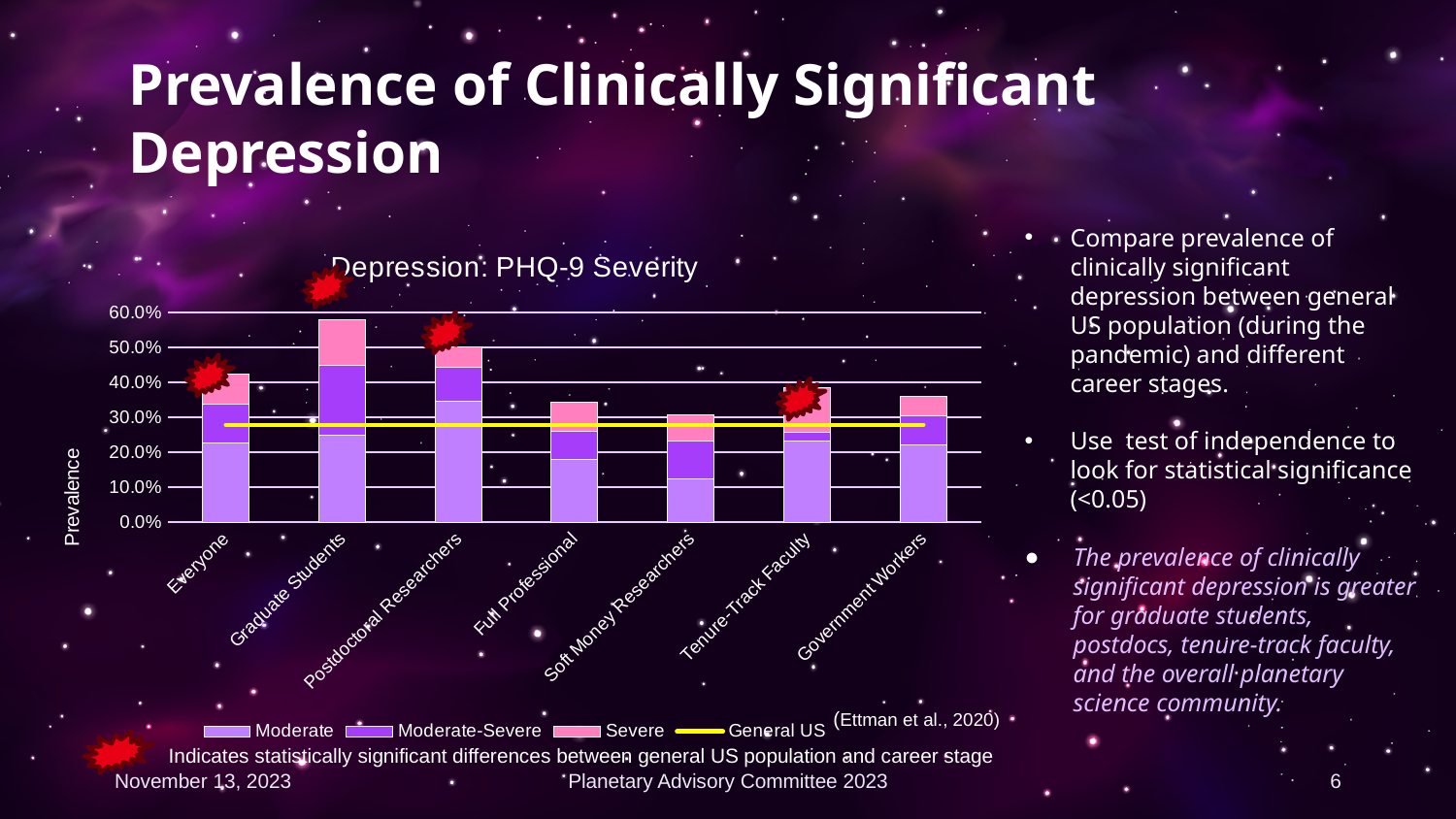
What kind of chart is shown on the slide? Stacked bar chart with a line (combination bar and line chart) Is the total stacked value for Soft Money Researchers greater or less than 40.0%? less Which has a taller stacked bar, Postdoctoral Researchers or Tenure-Track Faculty? Postdoctoral Researchers Is the total stacked value for Graduate Students greater or less than 50.0%? greater Is the total stacked value for Everyone greater or less than 50.0%? less How many career-stage categories are shown on the x axis of the chart? 7 What is the label on the vertical axis of the chart? Prevalence Which has a taller stacked bar, Graduate Students or Everyone? Graduate Students How many entries does the chart legend list? 4 What is the title of the chart? Depression: PHQ-9 Severity Which category has the tallest stacked bar in the chart? Graduate Students